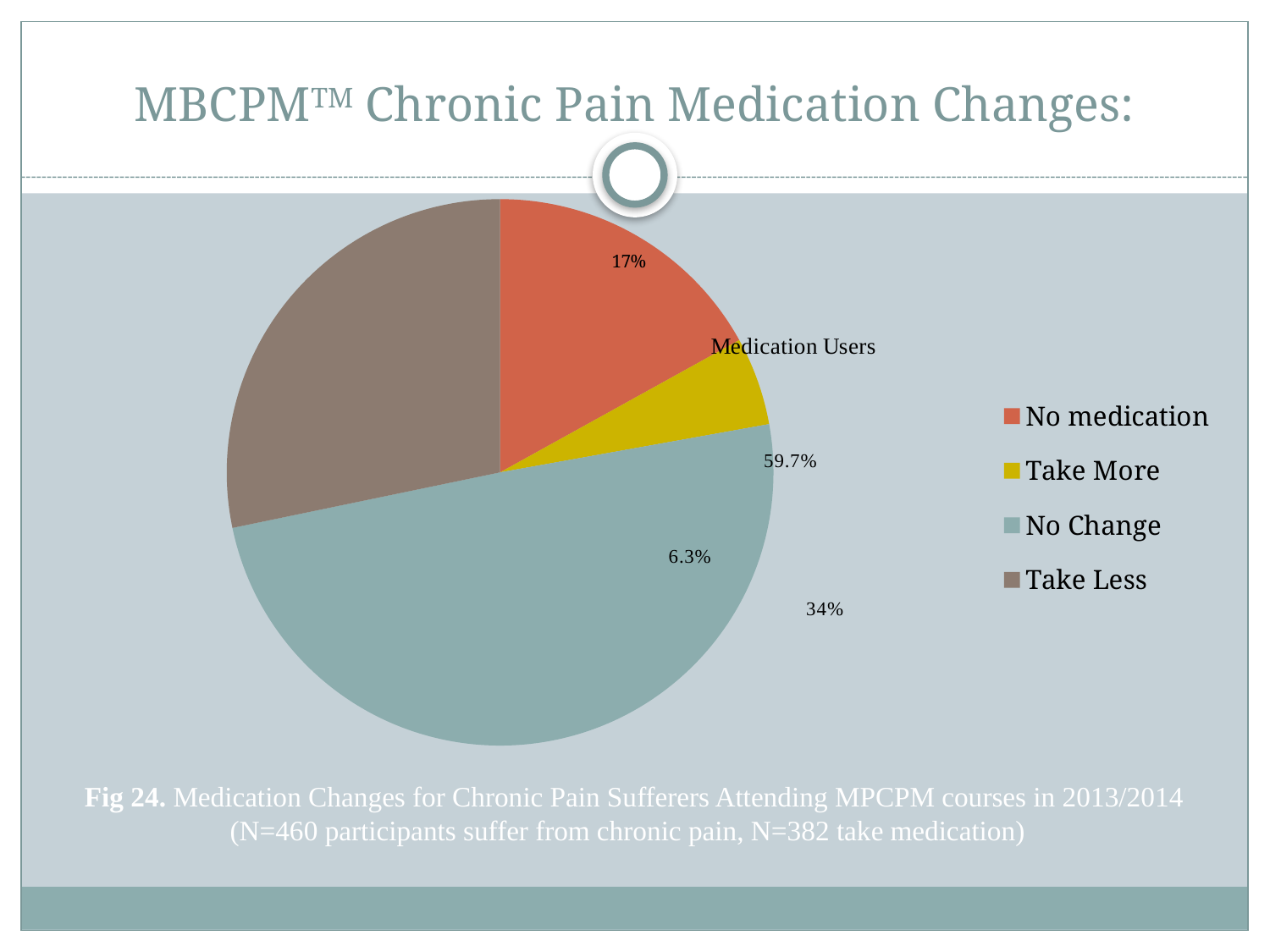
Which category has the largest slice of the pie chart? No Change Which slice is larger, No Change or Take Less? No Change Which category has the smallest slice of the pie chart? Take More Which slice is larger, No medication or Take More? No medication What colour is used for the No Change slice in the pie chart? Teal (blue-grey) How many slices does the pie chart have? 4 Which slice is larger, Take Less or No medication? Take Less What kind of chart is shown on the slide? Pie chart How many categories does the legend of the pie chart list? 4 What is the title shown on the pie chart? Medication Users What percentage label is shown on the No medication slice? 17%